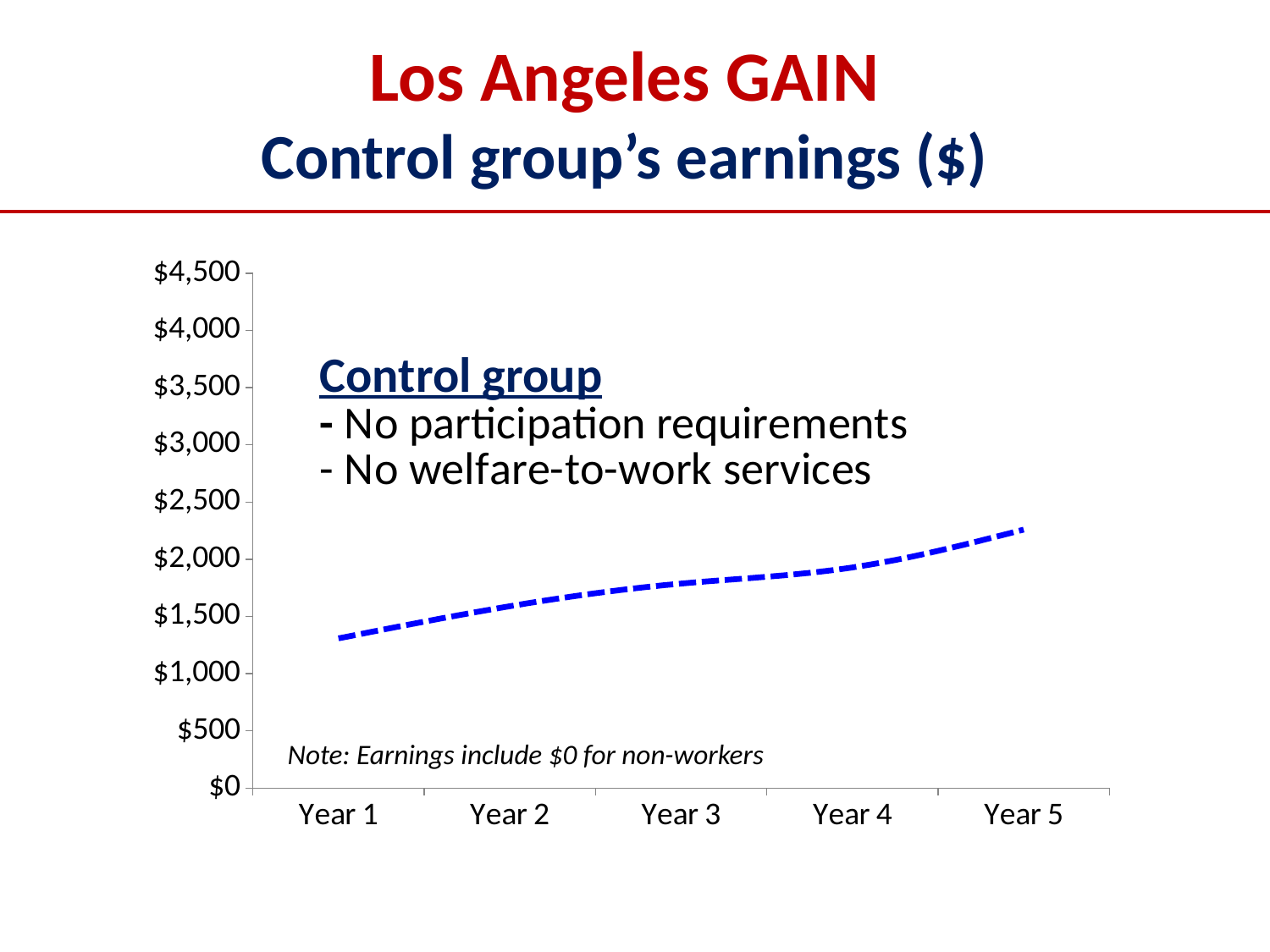
In which year are the control group's earnings highest? Year 5 What kind of chart is shown on the slide? Line chart What is the title of the chart on the slide? Los Angeles GAIN Control group's earnings ($) Is the value for Year 3 greater or less than $1,500? greater How many years are plotted along the x axis? 5 Is the value for Year 1 greater or less than $1,500? less Is the value for Year 5 greater or less than $2,000? greater What does the note at the bottom of the chart say? Note: Earnings include $0 for non-workers Do the control group's earnings rise or fall from Year 1 to Year 5? Rise Which year has higher earnings, Year 1 or Year 5? Year 5 In which year are the control group's earnings lowest? Year 1